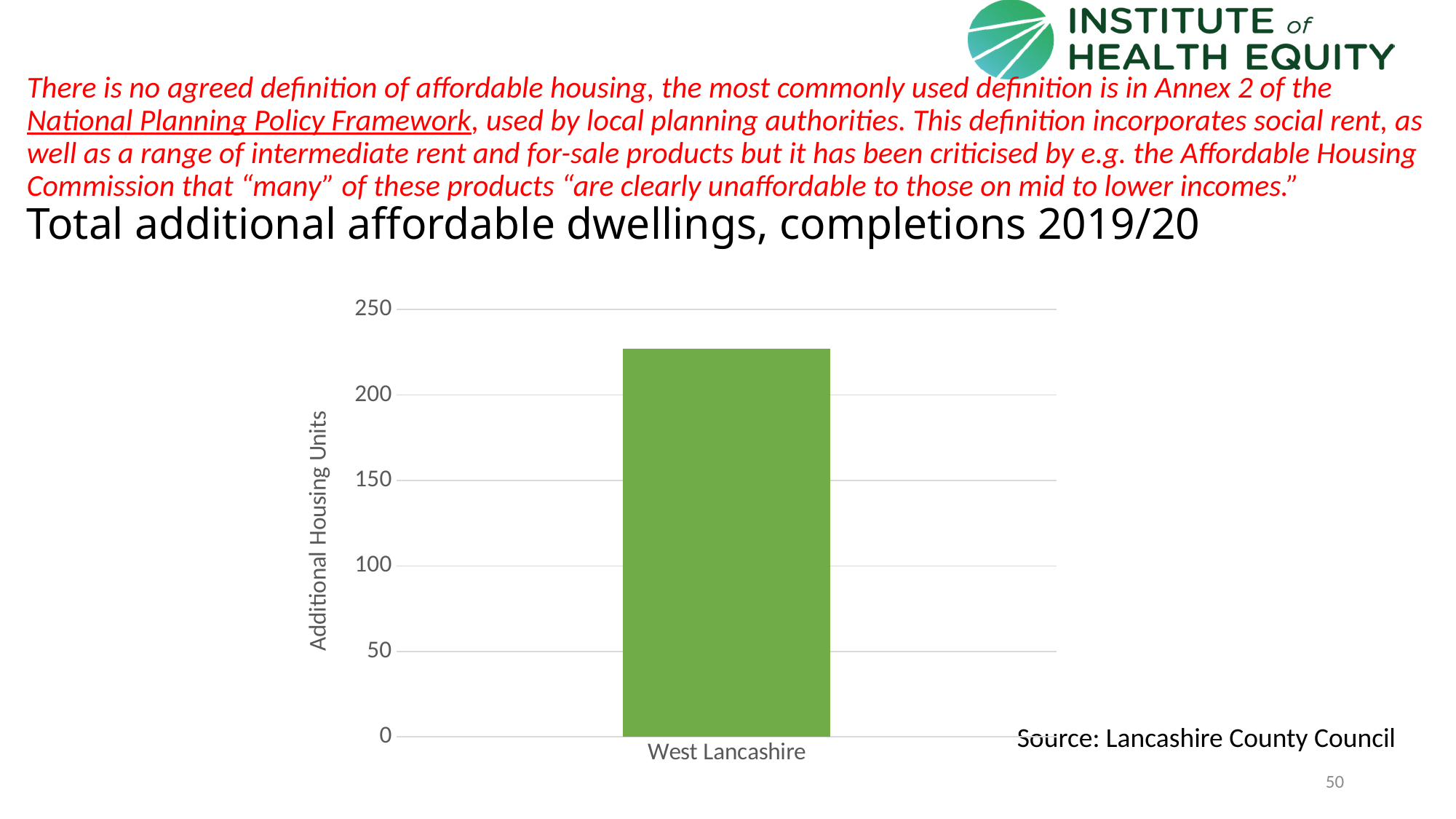
What is the highest value shown on the vertical axis of the chart? 250 How many categories are plotted on the chart? 1 Which category is shown on the x axis of the chart? West Lancashire What kind of chart is shown on the slide? bar chart What is the label on the vertical axis of the chart? Additional Housing Units Is the value for West Lancashire greater or less than 200? greater Is the value for West Lancashire greater or less than 150? greater Is the value for West Lancashire greater or less than 250? less